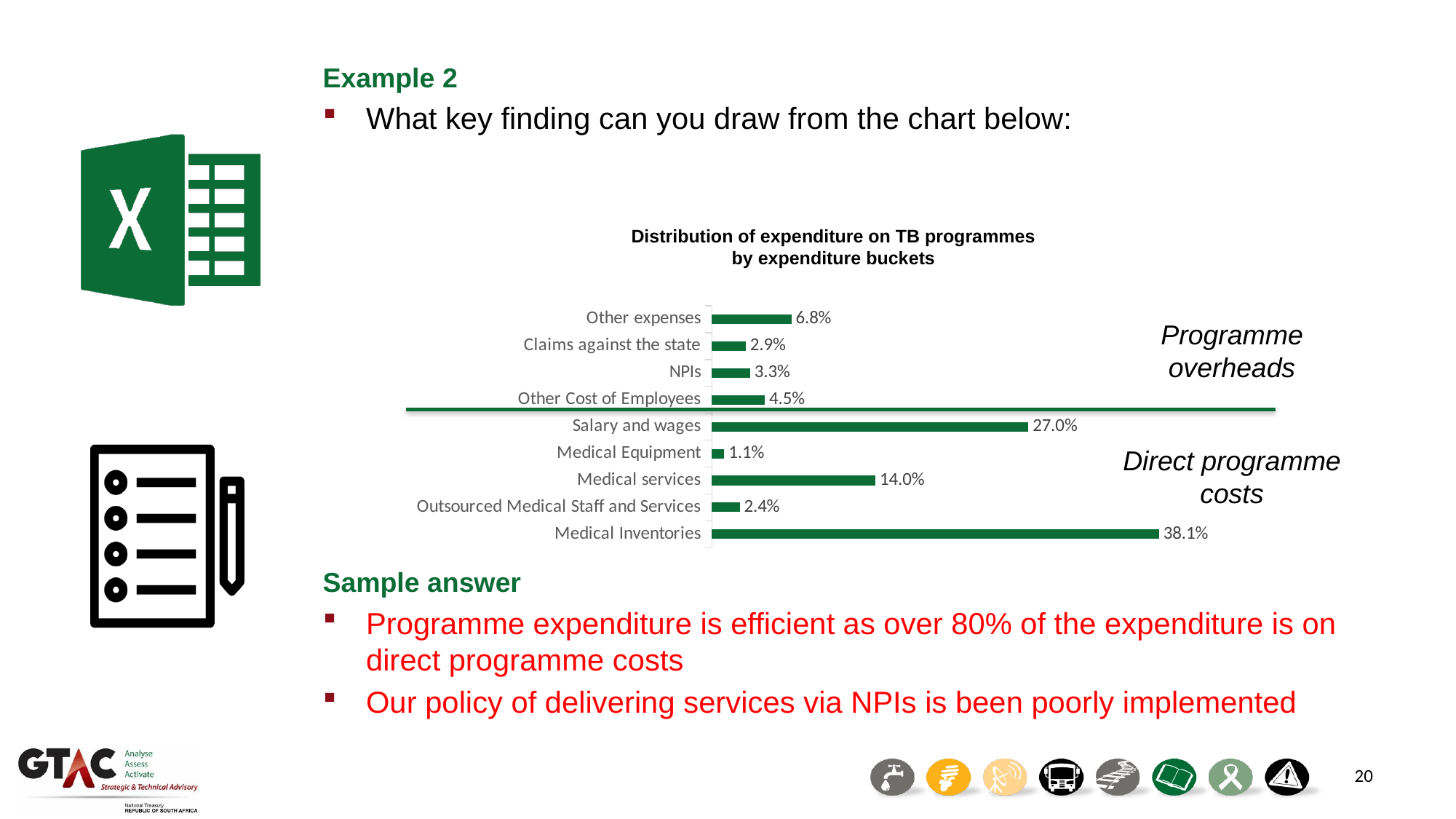
Which is larger, Medical services or Other expenses? Medical services What is the title of the chart? Distribution of expenditure on TB programmes by expenditure buckets What kind of chart is shown? Bar chart What is the difference between Medical Inventories and Salary and wages? 11.1% What is the difference between Other expenses and Other Cost of Employees? 2.3% How many categories are shown in the chart? 9 What is the value for NPIs? 3.3% What is the value for Medical Inventories? 38.1% Which category has the highest value? Medical Inventories What is the value for Salary and wages? 27.0% Which category has the lowest value? Medical Equipment What is the value for Outsourced Medical Staff and Services? 2.4%